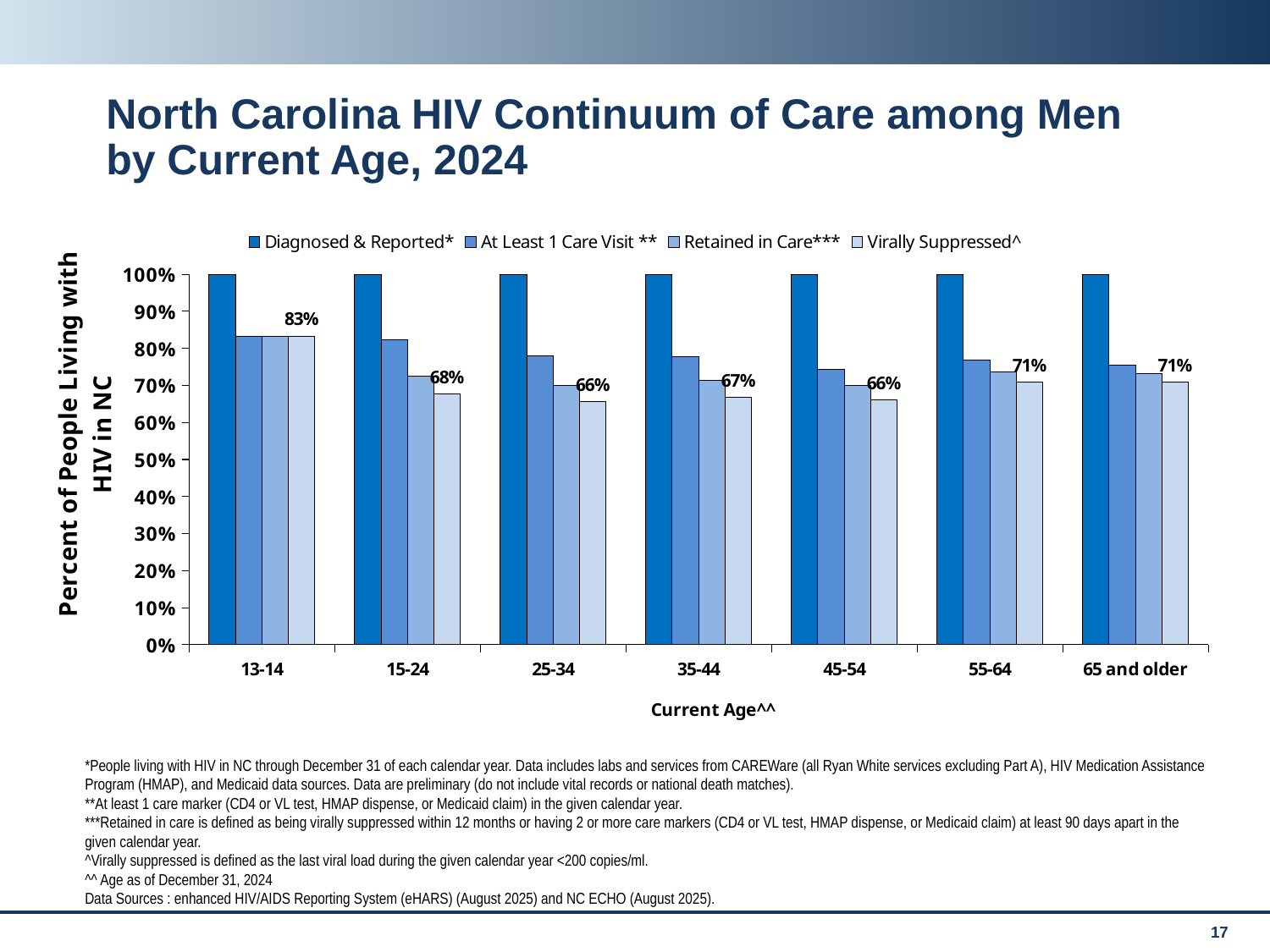
How many age groups are shown on the x axis? 7 Which is larger, the Virally Suppressed^ value for 35-44 or for 55-64? 55-64 How many series does the legend list? 4 What kind of chart is shown on the slide? Bar chart What is the difference between the Virally Suppressed^ values for the 13-14 and 15-24 age groups? 15% What is the label of the x axis? Current Age^^ What is the Virally Suppressed^ value for the 25-34 age group? 66% What is the Virally Suppressed^ value for the 13-14 age group? 83% Which age group has the highest Virally Suppressed^ value? 13-14 Is the Retained in Care*** value for the 45-54 age group greater or less than 80%? less What is the Virally Suppressed^ value for the 55-64 age group? 71% Is the At Least 1 Care Visit ** value for the 13-14 age group greater or less than 80%? greater